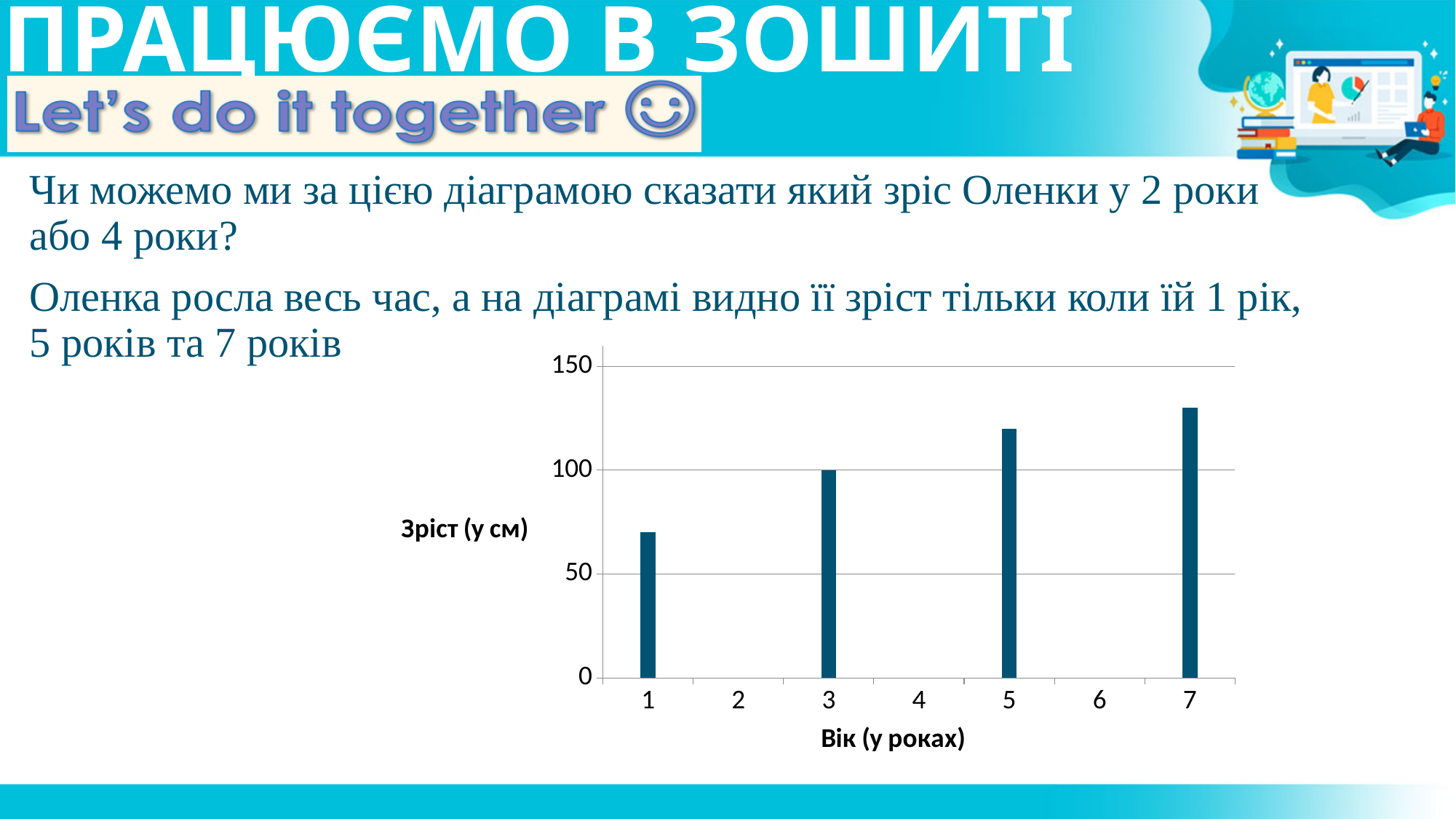
What is the height value shown for age 3? 100 At which age is the plotted height the smallest? 1 Which is larger, the value for age 1 or the value for age 3? age 3 What kind of chart is shown on the slide? bar chart Is the value for age 7 greater or less than 150? less Is the value for age 1 greater or less than 100? less Is the value for age 1 greater or less than 50? greater What is the title of the horizontal axis of the chart? Вік (у роках) How many bars are plotted on the chart? 4 At which age is the plotted height the greatest? 7 Do the bar values rise or fall as age increases along the x axis? rise